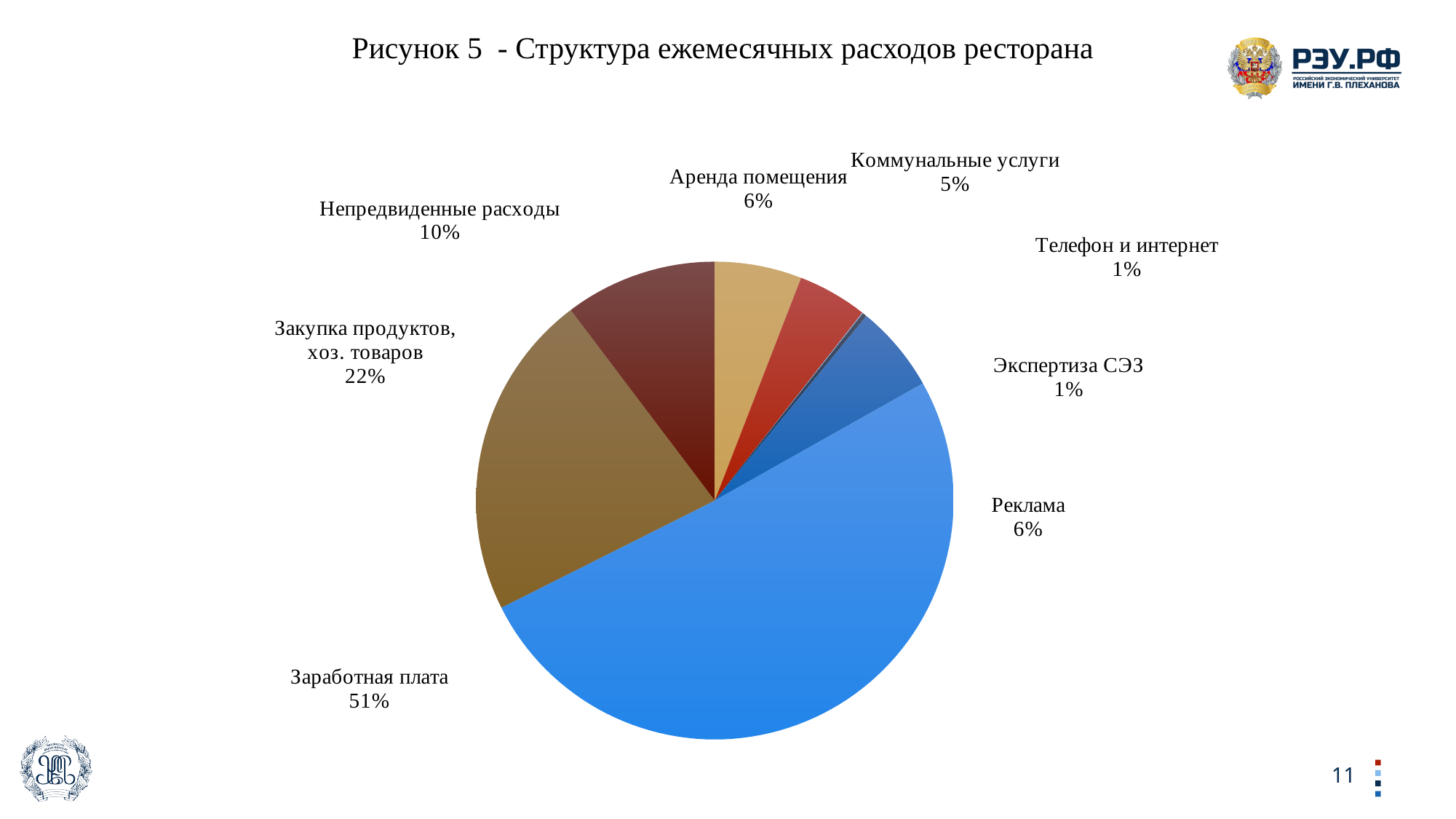
What kind of chart is shown on the slide? Pie chart What is the title of the chart? Рисунок 5 - Структура ежемесячных расходов ресторана What share of monthly expenses is Заработная плата? 51% Which is larger: Аренда помещения or Коммунальные услуги? Аренда помещения How many categories are shown in the pie chart? 8 What share of monthly expenses is Коммунальные услуги? 5% What is the difference in percentage points between Заработная плата and Закупка продуктов, хоз. товаров? 29 What share of monthly expenses is Непредвиденные расходы? 10% Which category has the largest share of monthly expenses? Заработная плата What share of monthly expenses is Реклама? 6% What share of monthly expenses is Закупка продуктов, хоз. товаров? 22% What is the combined share of Заработная плата and Закупка продуктов, хоз. товаров? 73%